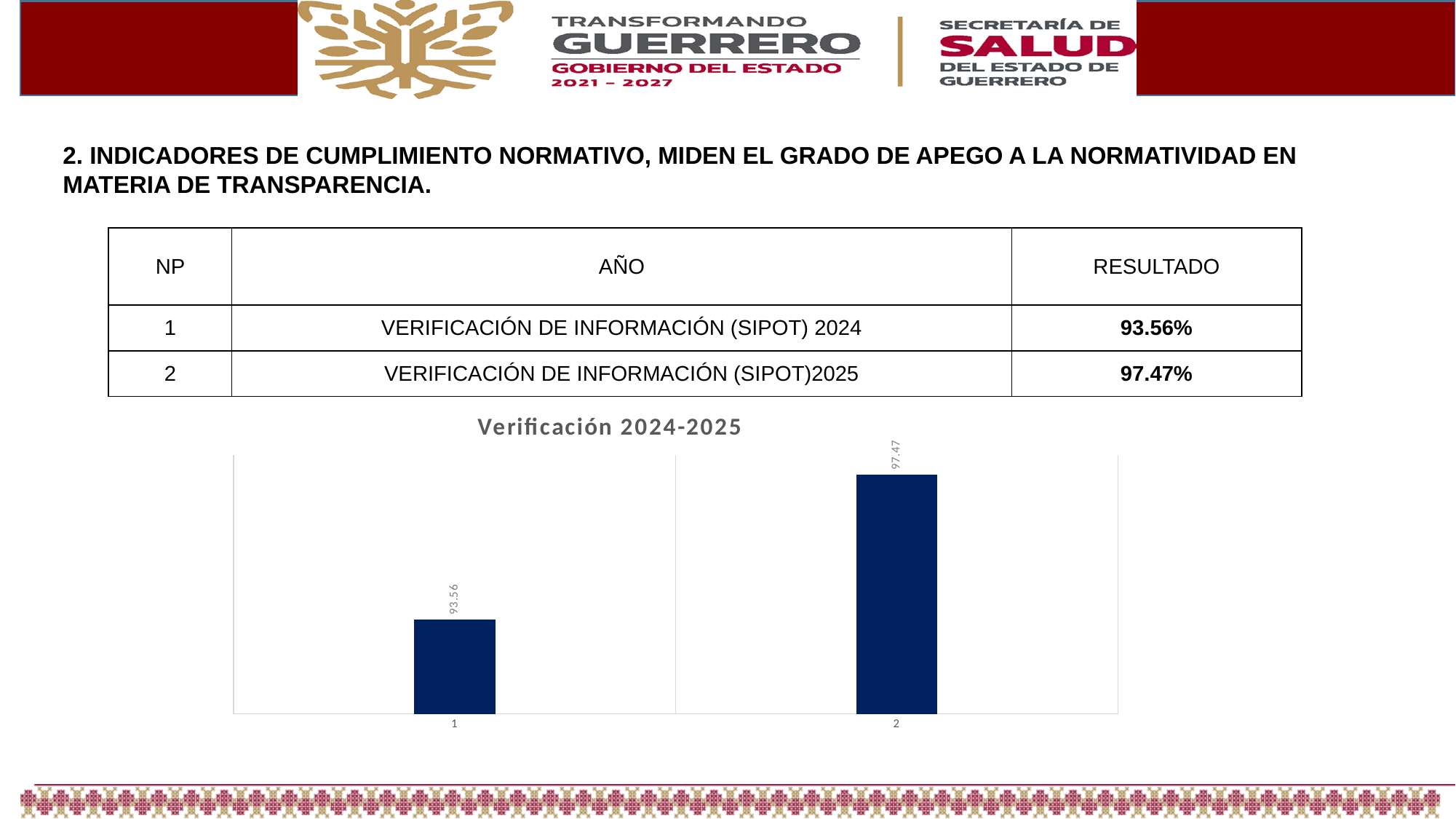
Do the values rise or fall from category 1 to category 2 in the chart? rise What kind of chart is shown on the slide? bar chart What is the value of the bar for category 2 in the chart? 97.47 How many bars are plotted in the chart? 2 Which is larger in the chart, the value for category 1 or the value for category 2? category 2 What is the value of the bar for category 1 in the chart? 93.56 What is the difference between the values for category 2 and category 1 in the chart? 3.91 Which category has the highest bar in the chart? 2 Which category has the lowest bar in the chart? 1 What colour are the bars in the chart? dark blue What is the title of the chart? Verificación 2024-2025